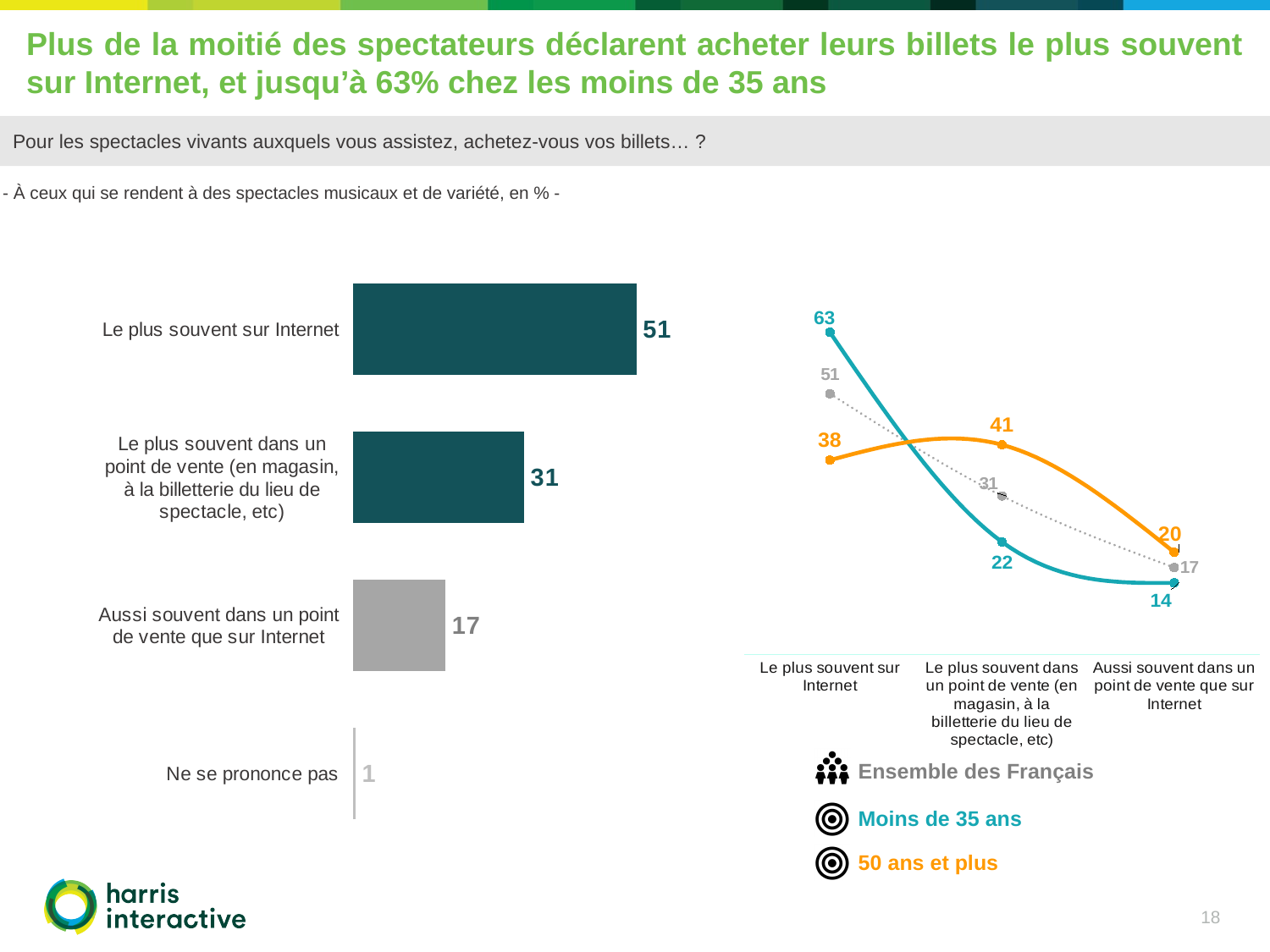
How many categories does the bar chart on the left show? 4 In the bar chart on the left, what is the value for "Le plus souvent sur Internet"? 51 In the line chart on the right, what is the value for "Moins de 35 ans" for "Le plus souvent sur Internet"? 63 What kind of chart is on the left of the slide? bar chart In the bar chart on the left, which category has the highest value? Le plus souvent sur Internet In the line chart on the right, does the "Moins de 35 ans" line rise or fall from left to right? fall In the line chart on the right, what is the difference between "Moins de 35 ans" and "50 ans et plus" for "Le plus souvent sur Internet"? 25 In the bar chart on the left, what is the value for "Ne se prononce pas"? 1 In the line chart on the right, what is the value for "50 ans et plus" for "Le plus souvent dans un point de vente"? 41 In the line chart on the right, which is larger for "Aussi souvent dans un point de vente que sur Internet": "Moins de 35 ans" or "50 ans et plus"? 50 ans et plus How many series does the legend of the line chart on the right list? 3 In the bar chart on the left, what is the difference between "Le plus souvent sur Internet" and "Le plus souvent dans un point de vente"? 20